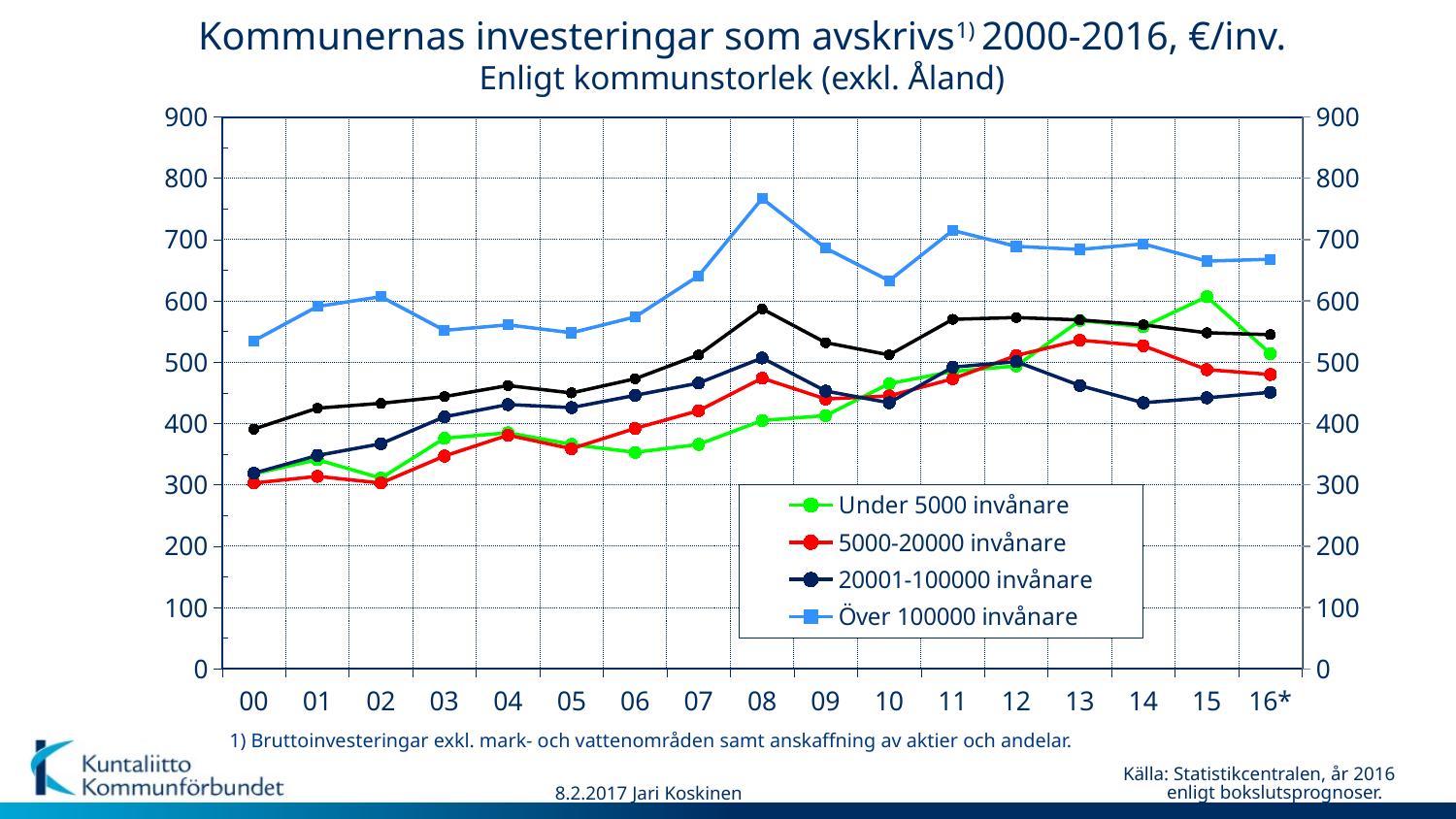
Is the value for 20001-100000 invånare in 08 greater or less than 600? less Is the value for 5000-20000 invånare in 13 greater or less than 500? greater What kind of chart is shown on the slide? line chart Is the value for Över 100000 invånare in 08 greater or less than 700? greater What unit is given in the chart title for the values? €/inv. Does the Över 100000 invånare series rise or fall from 00 to 08? rise How many years are plotted along the x axis? 17 Which series has the highest value in 08? Över 100000 invånare In which year does the Över 100000 invånare series reach its highest value? 08 How many series does the legend list? 4 In 15, which series has the larger value: Under 5000 invånare or 5000-20000 invånare? Under 5000 invånare